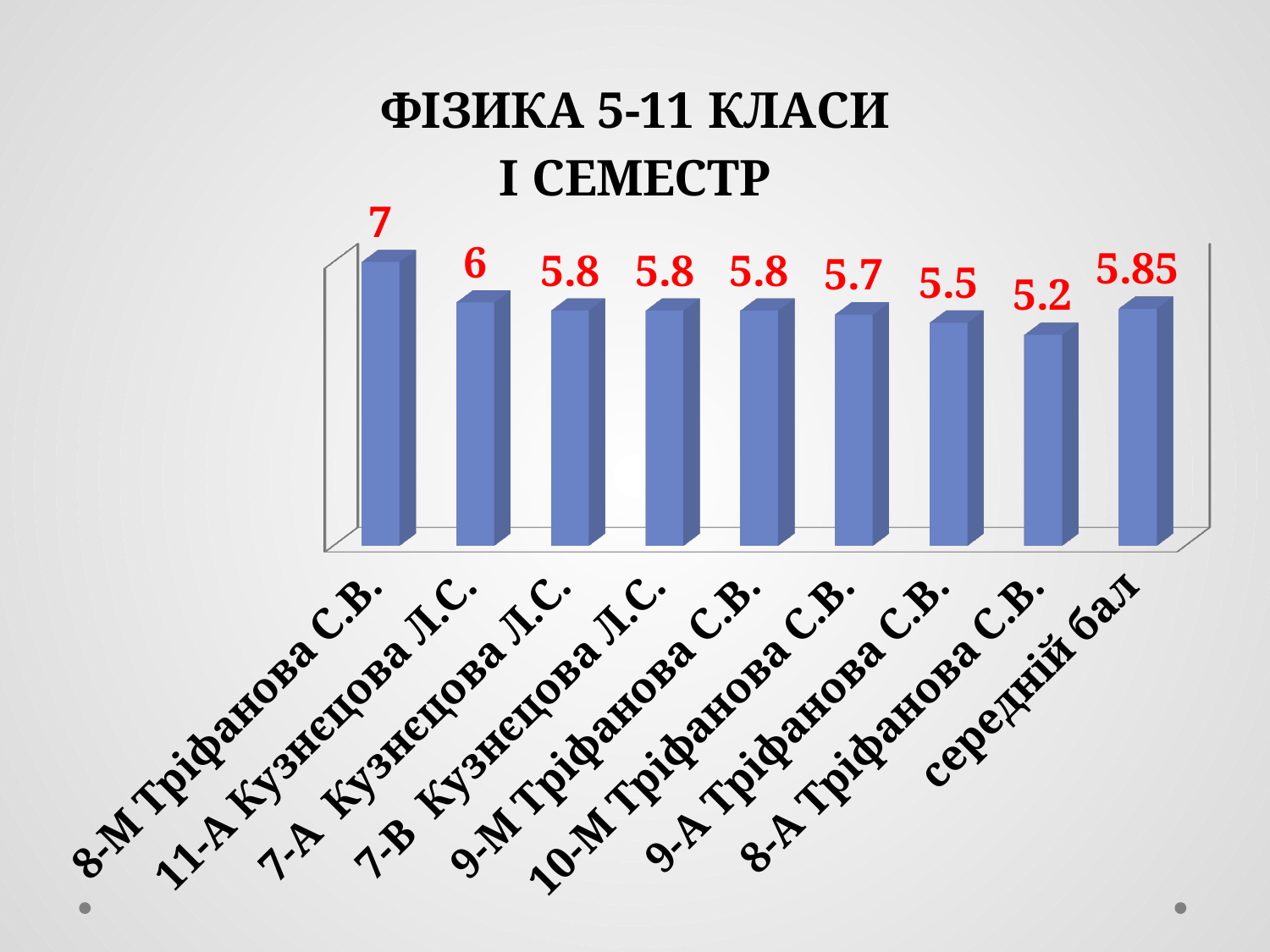
Which is larger, the value for 9-А Тріфанова С.В. or the value for 11-А Кузнєцова Л.С.? 11-А Кузнєцова Л.С. What is the difference between the value for 11-А Кузнєцова Л.С. and the value for 9-А Тріфанова С.В.? 0.5 What kind of chart is shown on the slide? Bar chart What is the title of the chart? ФІЗИКА 5-11 КЛАСИ І СЕМЕСТР What is the value for 8-М Тріфанова С.В.? 7 What is the value for 11-А Кузнєцова Л.С.? 6 What is the value for 10-М Тріфанова С.В.? 5.7 How many bars are shown in the chart? 9 What is the difference between the values for 8-М Тріфанова С.В. and 8-А Тріфанова С.В.? 1.8 Which category has the highest value? 8-М Тріфанова С.В. What is the value labelled середній бал? 5.85 Which category has the lowest value? 8-А Тріфанова С.В.